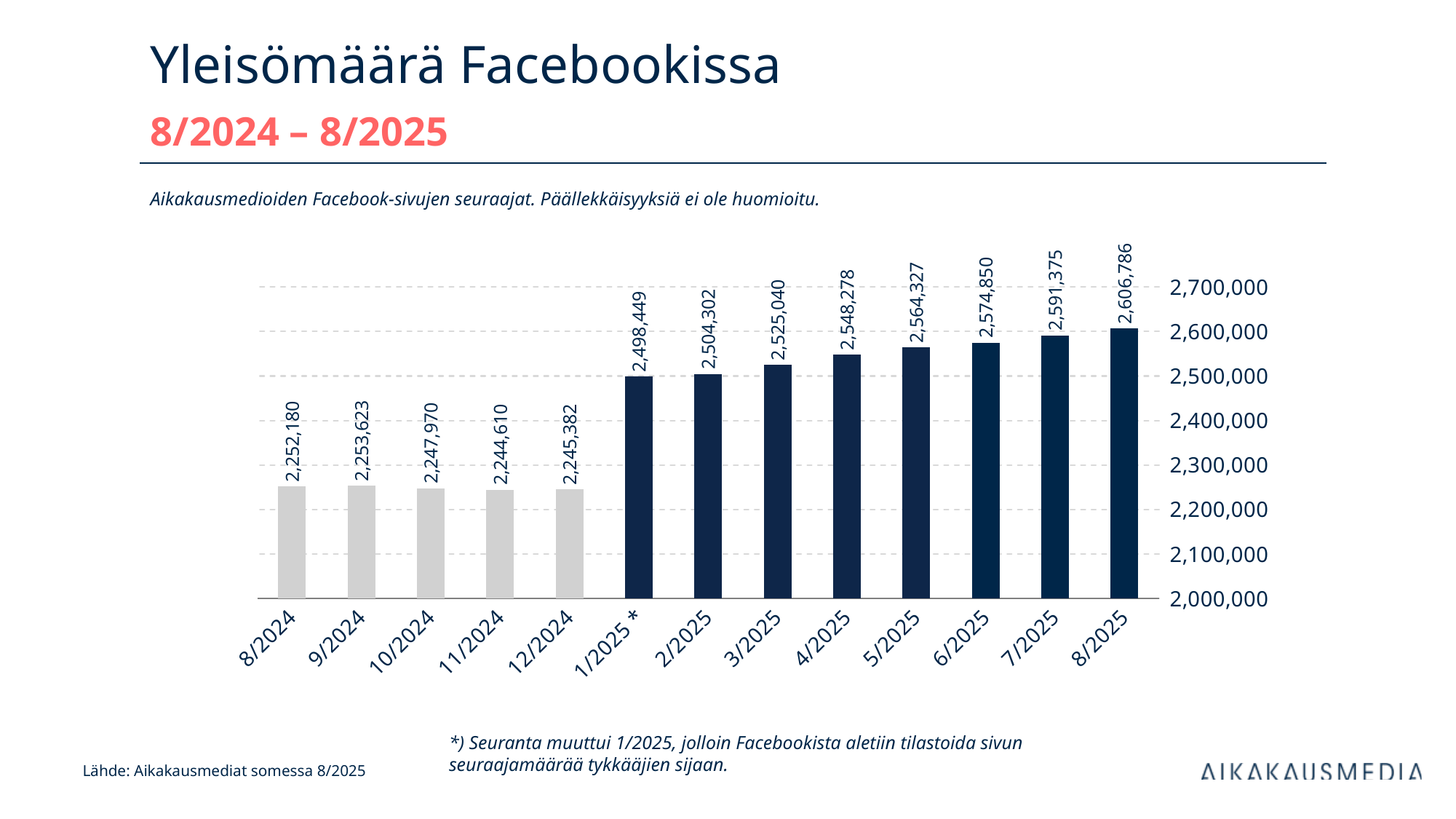
Is the value for 3/2025 greater or less than 2,500,000? greater Which is larger, the value for 9/2024 or the value for 10/2024? 9/2024 What is the difference between the values for 1/2025 and 12/2024? 253,067 What is the value for 1/2025? 2,498,449 Which month has the highest value? 8/2025 How many months are shown on the chart? 13 Do the values rise or fall from 1/2025 to 8/2025? rise What kind of chart is shown on the slide? bar chart What is the value for 8/2025? 2,606,786 What is the difference between the values for 8/2025 and 8/2024? 354,606 What is the value for 11/2024? 2,244,610 Which month has the lowest value? 11/2024